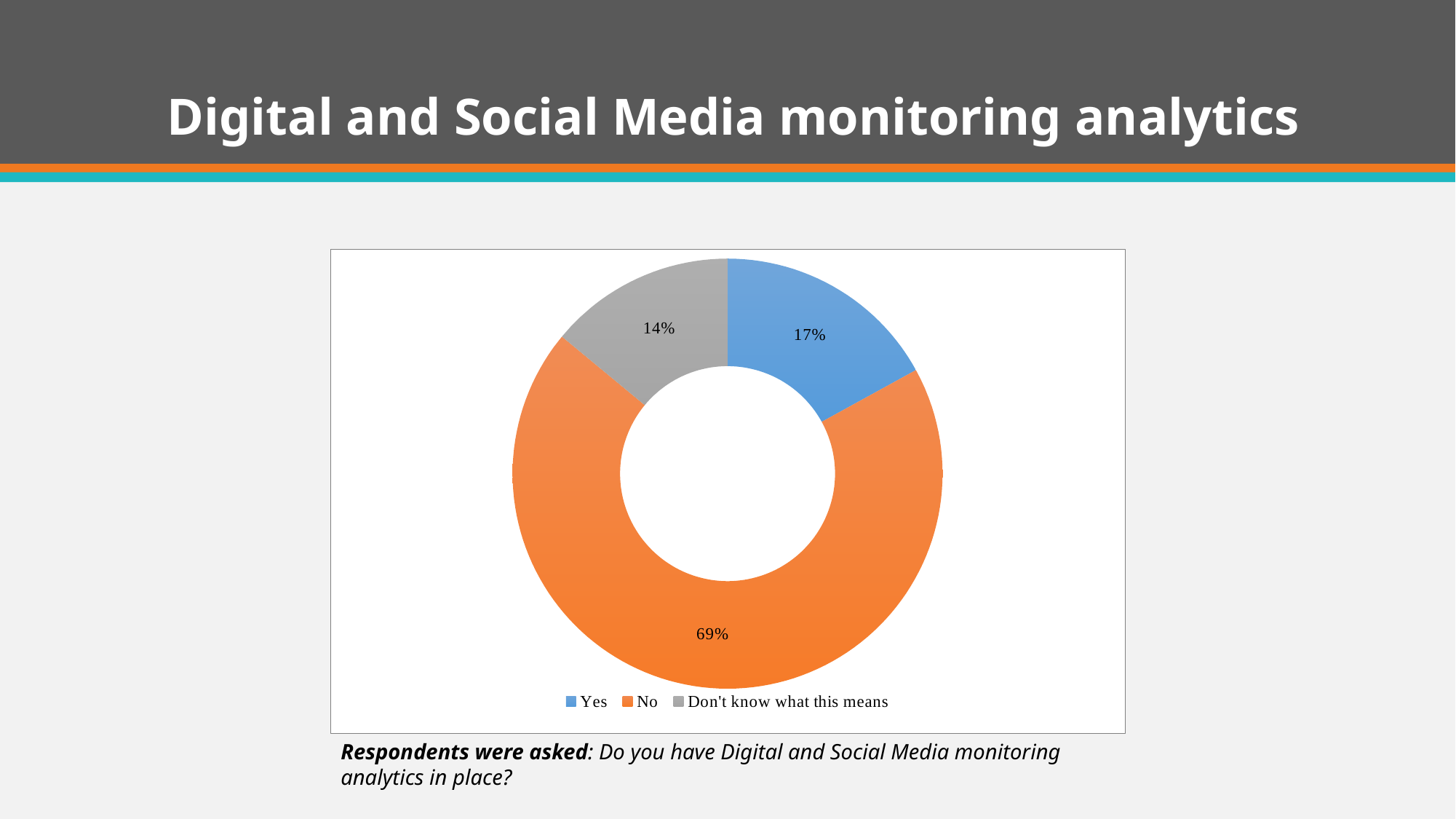
What is the combined share of "Yes" and "Don't know what this means"? 31% Which response has the smallest share of the chart? Don't know what this means What percentage of respondents answered "Yes"? 17% What percentage of respondents answered "Don't know what this means"? 14% Which response has the largest share of the chart? No What is the difference in percentage points between the "No" and "Yes" responses? 52 What percentage of respondents answered "No"? 69% What kind of chart is shown on the slide? Doughnut chart How many entries does the legend list? 3 How many categories are shown in the chart? 3 Which is larger, the share for "Yes" or the share for "Don't know what this means"? Yes What colour represents the "No" response in the chart? Orange